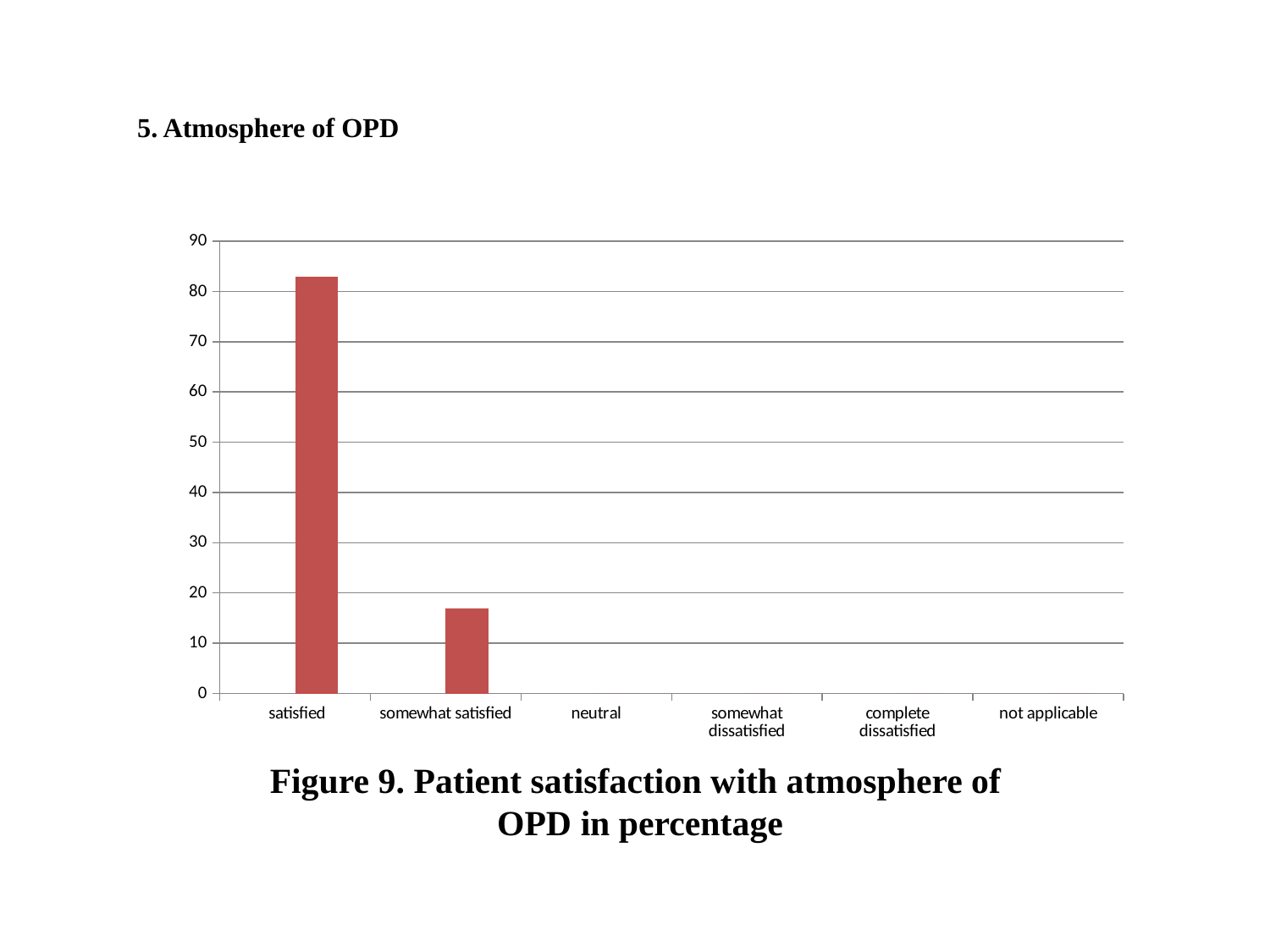
Do the values rise or fall moving from satisfied to somewhat satisfied along the x axis? fall Is the value for somewhat satisfied greater or less than 10? greater How many categories are shown on the x axis of the chart? 6 Which is larger, the value for satisfied or the value for somewhat satisfied? satisfied What colour are the bars in the chart? red Is the value for satisfied greater or less than 90? less Which category has the highest value in the chart? satisfied Is the value for somewhat satisfied greater or less than 20? less What is the figure caption below the chart? Figure 9. Patient satisfaction with atmosphere of OPD in percentage What kind of chart is shown on the slide? bar chart